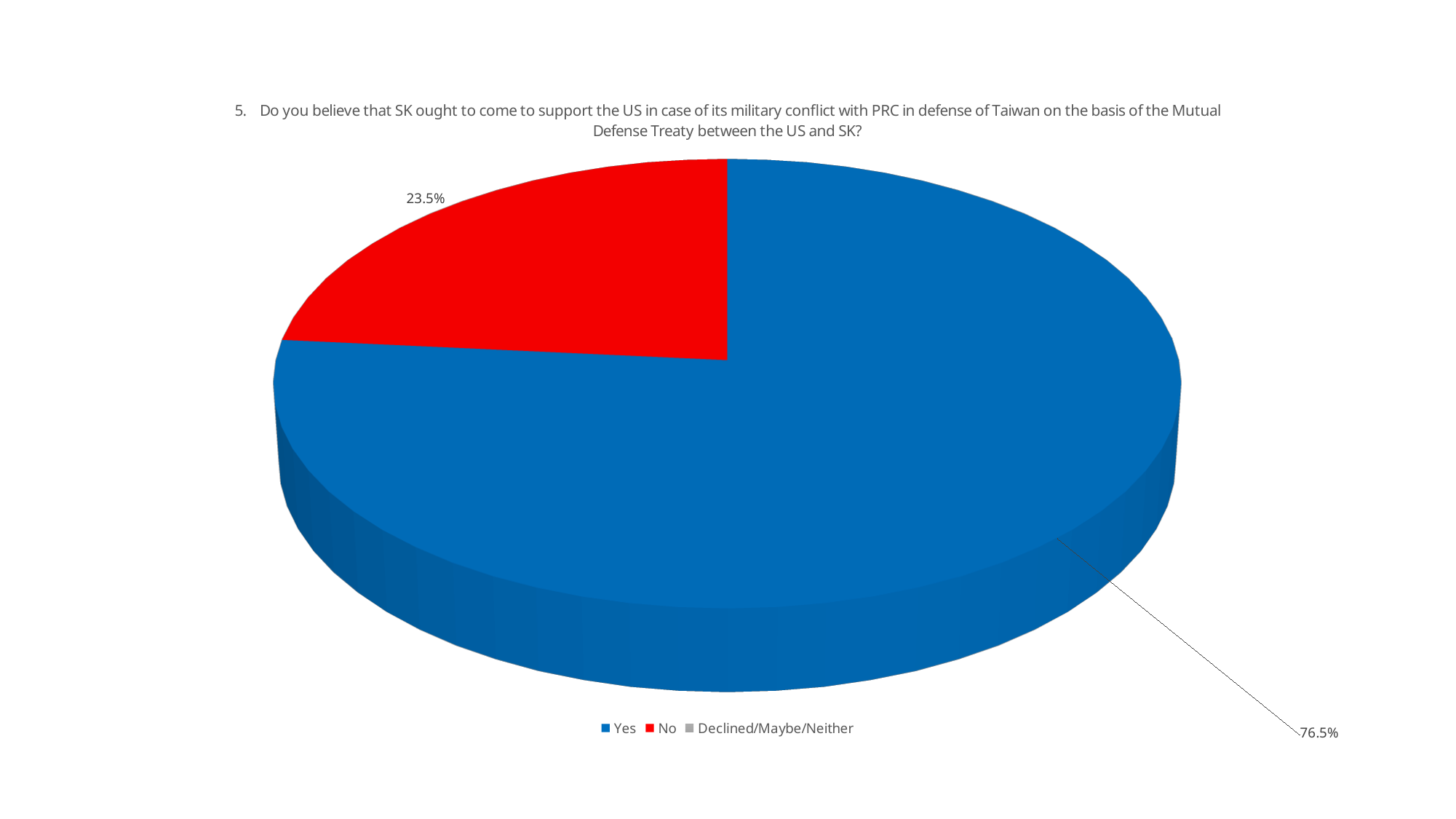
What percentage of respondents answered "No"? 23.5% How many slices are visible in the pie? 2 Which of the two visible slices is smaller, "Yes" or "No"? No What colour is the "Yes" slice? blue Is the share for "Yes" larger or smaller than the share for "No"? larger What kind of chart is shown on the slide? pie chart What percentage of respondents answered "Yes"? 76.5% What is the combined share of the "Yes" and "No" slices? 100.0% How many entries does the legend list? 3 Which response has the largest share of the pie? Yes What is the difference in percentage points between the "Yes" and "No" shares? 53.0 percentage points What colour is the "No" slice? red